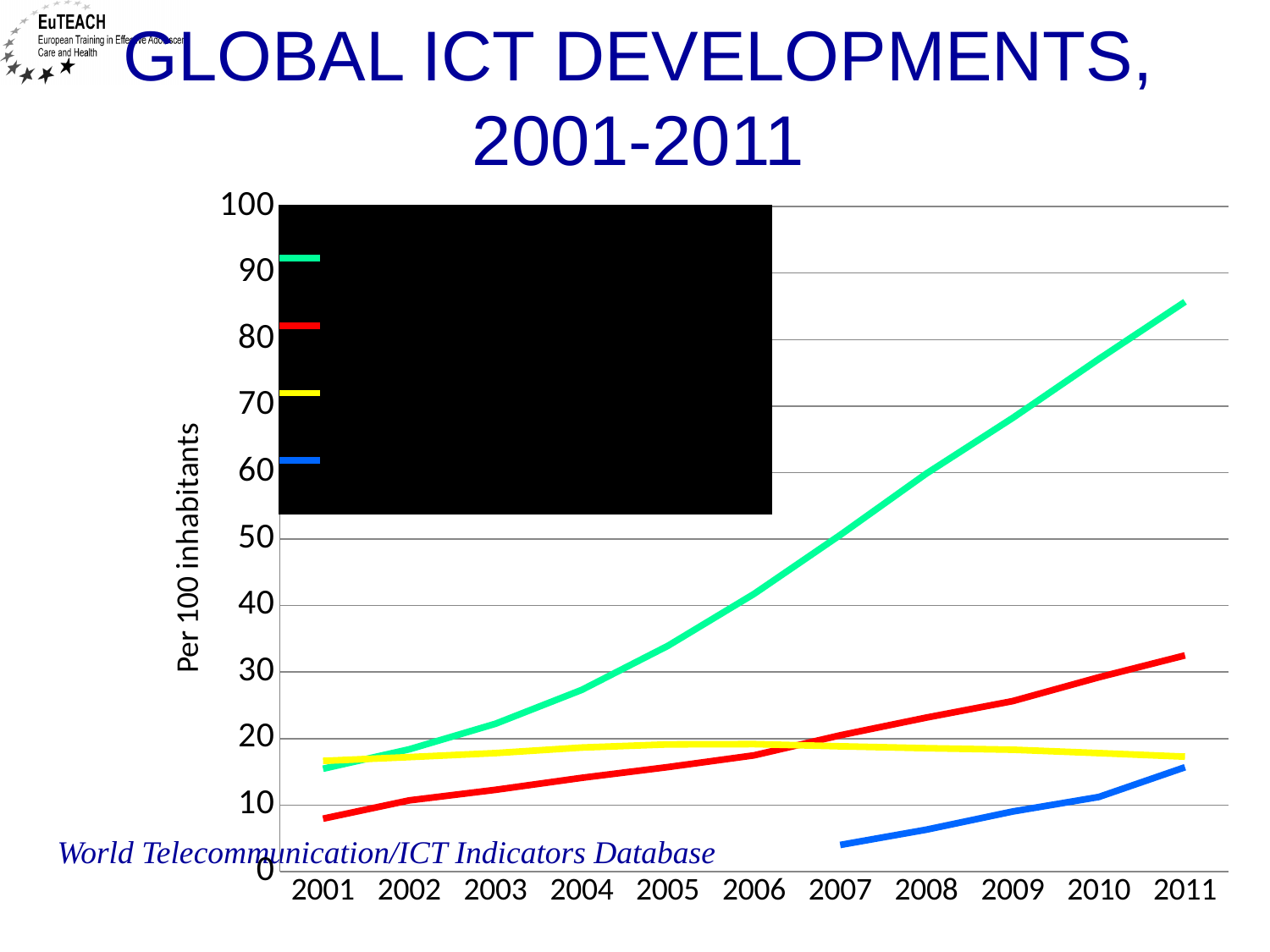
How many series does the chart's legend list? 4 Is the value of the red line in 2001 greater or less than 10? less Is the value of the blue line in 2007 greater or less than 10? less Which line has the lowest value in 2011? the blue line What is the label of the y axis? Per 100 inhabitants In 2001, which is higher: the yellow line or the red line? the yellow line What kind of chart is shown on the slide? line chart Does the green line rise or fall from 2001 to 2011? rises Is the value of the green line in 2005 greater or less than 40? less How many years are shown along the x axis of the chart? 11 Which line has the highest value in 2011? the green line